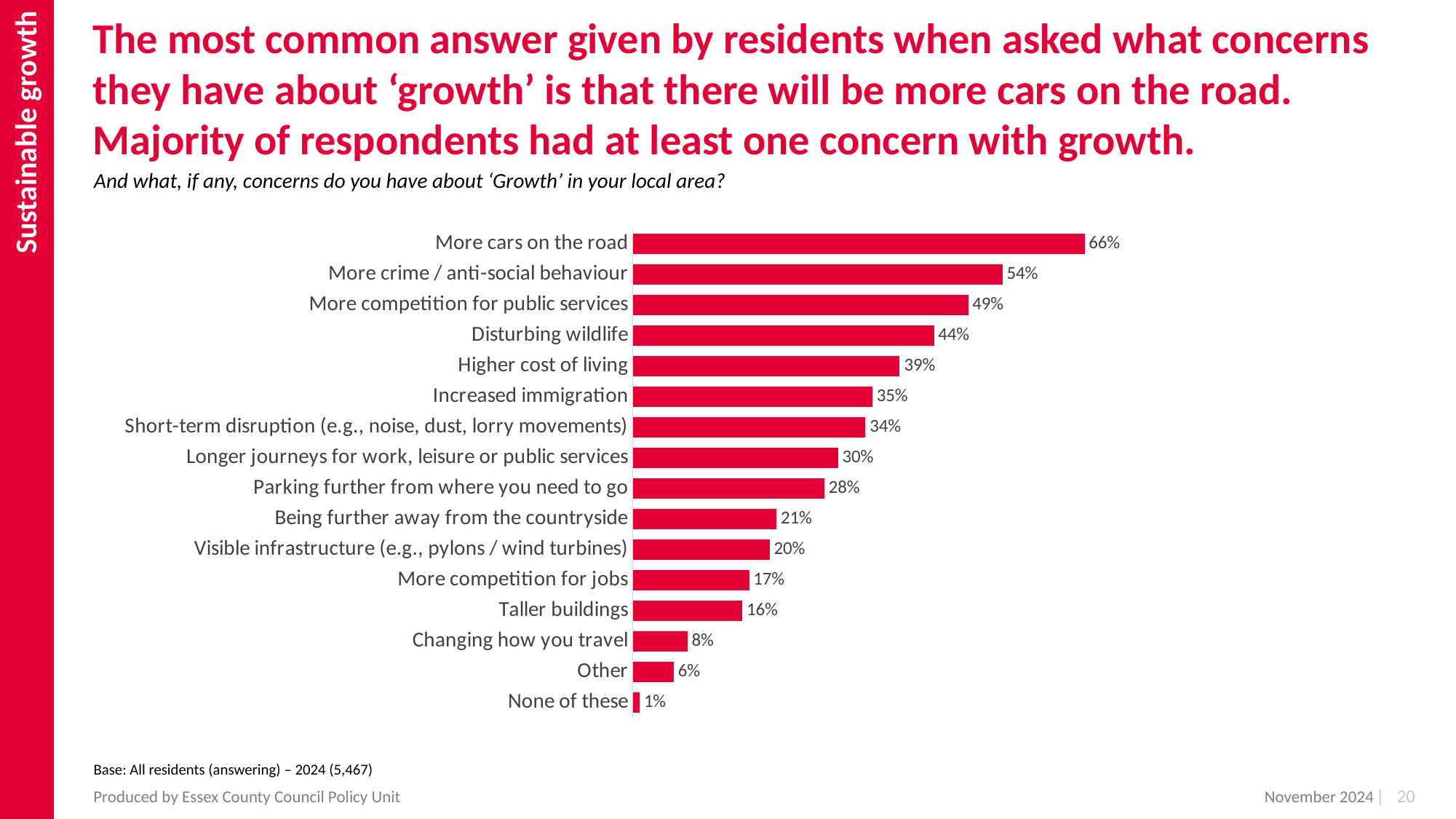
What is the difference in percentage points between 'More cars on the road' and 'More crime / anti-social behaviour'? 12 What is the value shown for 'Disturbing wildlife'? 44% What is the difference in percentage points between 'Higher cost of living' and 'Increased immigration'? 4 What percentage is shown for 'Taller buildings'? 16% What type of chart is shown on the slide? Bar chart Which concern has the highest percentage in the chart? More cars on the road Which category has the lowest percentage in the chart? None of these What colour are the bars in the chart? Red What is the value for 'None of these'? 1% Which is larger: the value for 'Parking further from where you need to go' or the value for 'Being further away from the countryside'? Parking further from where you need to go What percentage of residents said 'More cars on the road' was a concern about growth? 66% How many categories are shown in the chart? 16